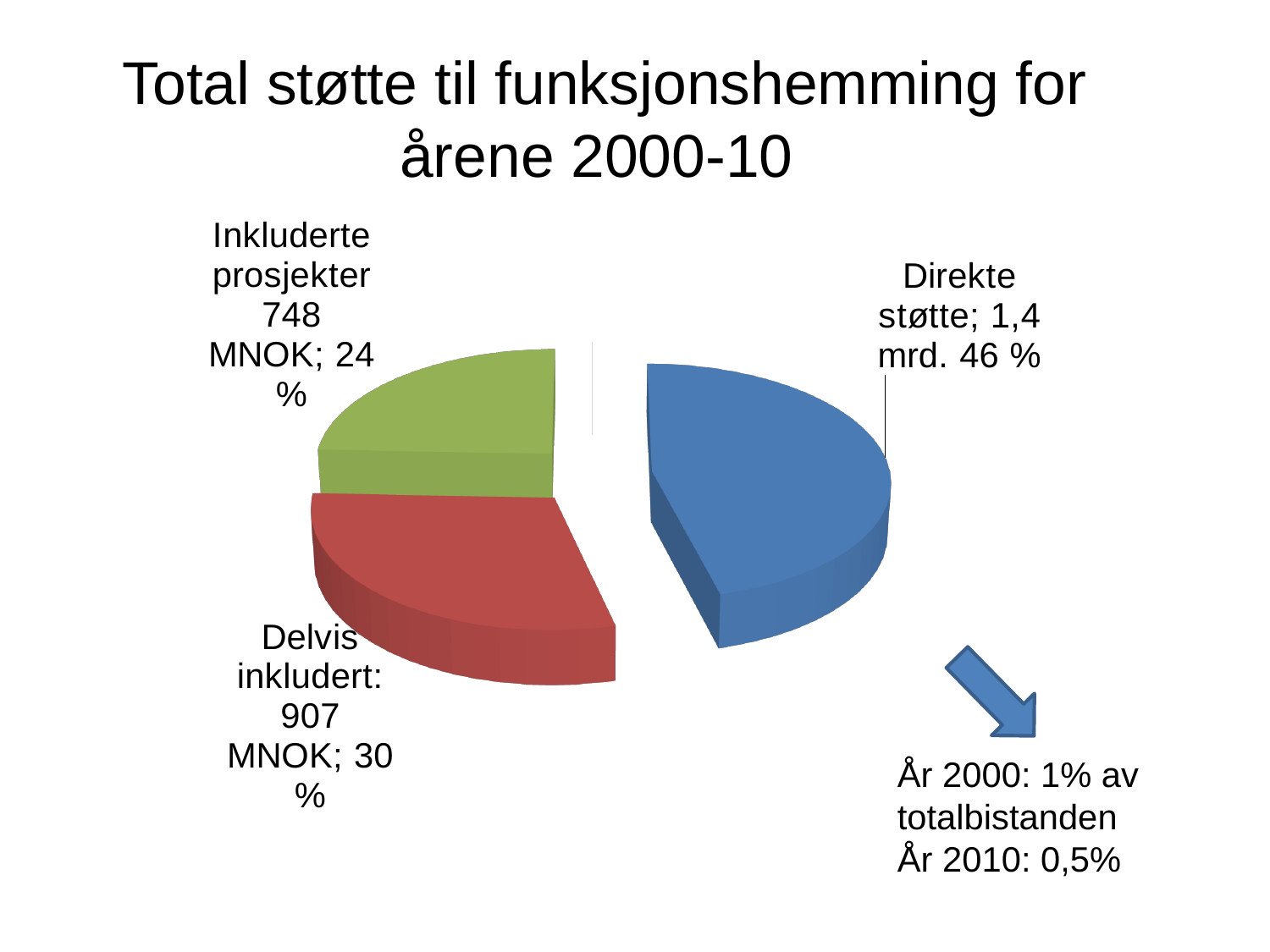
How many slices does the pie chart have? 3 What share of the pie does "Inkluderte prosjekter" represent? 24 % What amount is shown for "Delvis inkludert"? 907 MNOK What share of the pie does "Delvis inkludert" represent? 30 % What amount is shown for "Inkluderte prosjekter"? 748 MNOK Which slice of the pie chart is the largest? Direkte støtte Which is larger, the share for "Delvis inkludert" or the share for "Inkluderte prosjekter"? Delvis inkludert What kind of chart is shown on the slide? Pie chart Which slice of the pie chart is the smallest? Inkluderte prosjekter What share of the pie does "Direkte støtte" represent? 46 % What is the difference in percentage points between the shares of "Delvis inkludert" and "Inkluderte prosjekter"? 6 percentage points What amount is shown for "Direkte støtte"? 1,4 mrd.